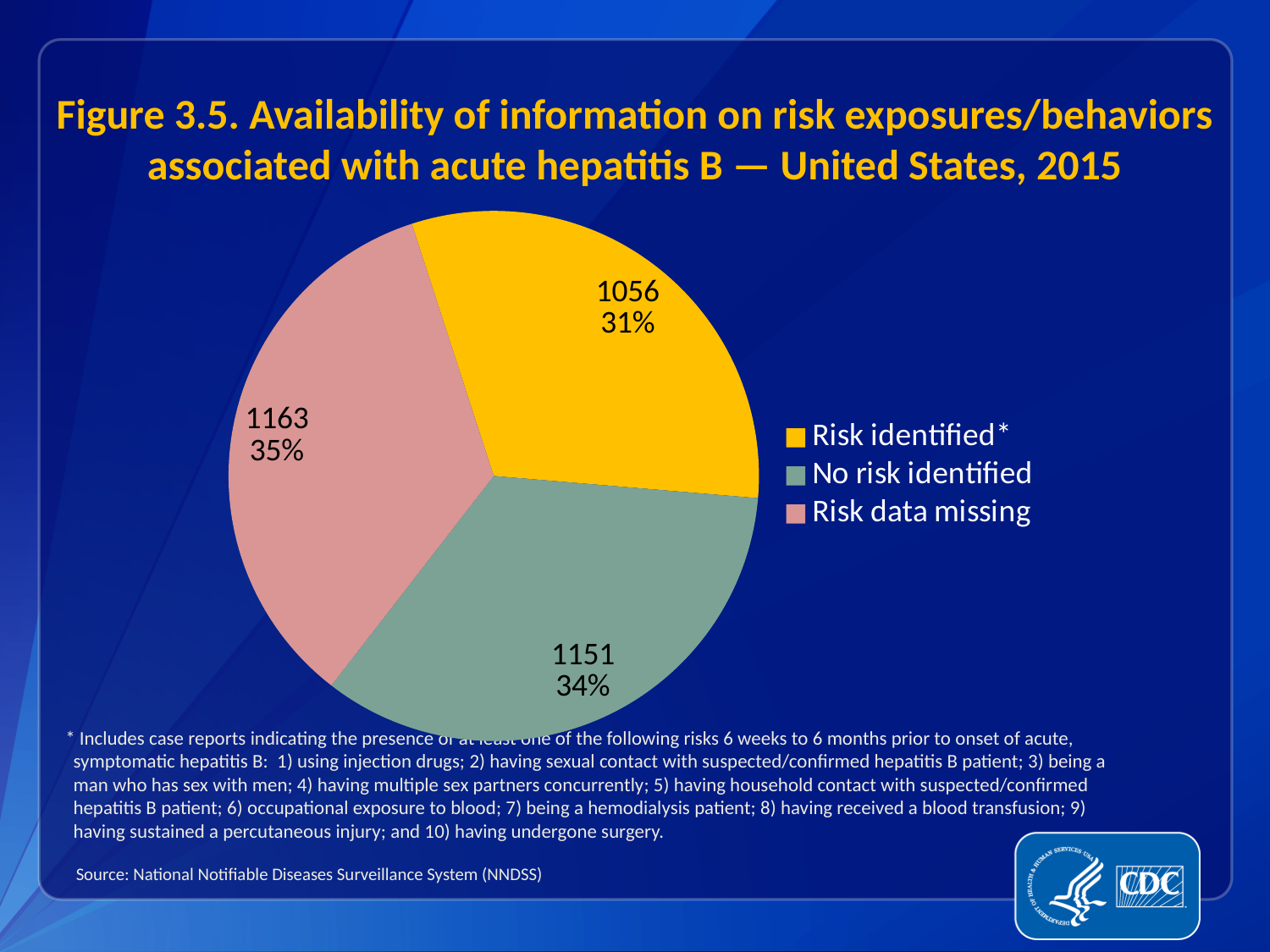
Which category has the smallest slice of the pie? Risk identified* What is the difference between the number of cases for 'Risk data missing' and 'Risk identified*'? 107 What kind of chart is shown on the slide? pie chart What is the number of cases for 'Risk data missing'? 1163 Which colour represents 'No risk identified' in the pie chart? green What is the number of cases for 'Risk identified*'? 1056 How many slices does the pie chart have? 3 Which category has the largest slice of the pie? Risk data missing What share of the pie does 'Risk identified*' represent? 31% What is the number of cases for 'No risk identified'? 1151 What share of the pie does 'Risk data missing' represent? 35% How many entries does the legend list? 3